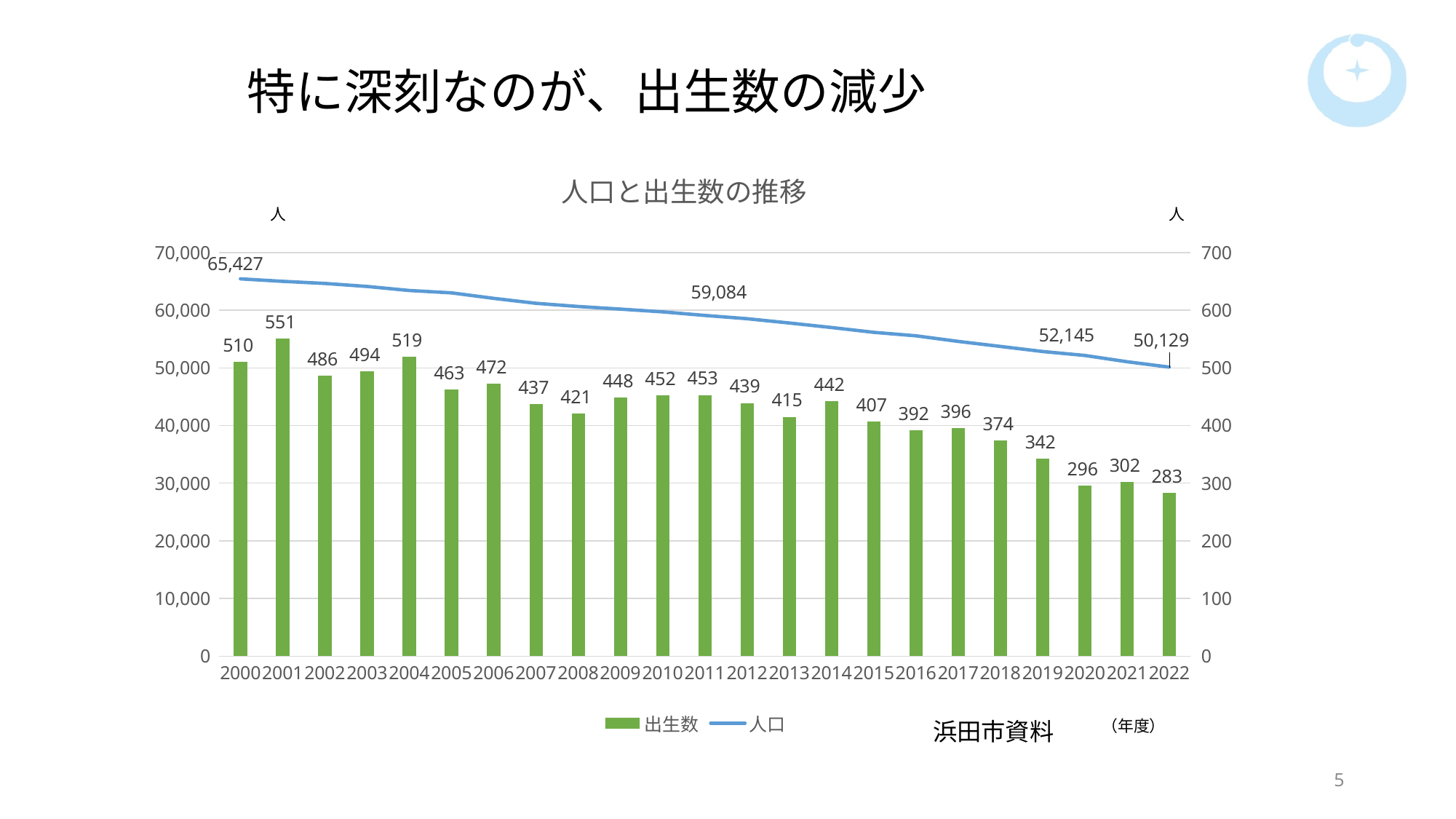
What is the population (人口) value labelled for 2000? 65,427 What is the population (人口) value labelled for 2022? 50,129 What is the number of births (出生数) shown for 2022? 283 How many years are shown on the x axis of the chart? 23 Which year had more births (出生数), 2020 or 2021? 2021 Which year has the lowest number of births (出生数)? 2022 Is the population (人口) value for 2015 greater or less than 60,000? less How many series does the legend list? 2 Which year has the highest number of births (出生数)? 2001 By how much did the number of births (出生数) fall from 2000 to 2022? 227 By how much did the population (人口) fall from 2000 to 2022? 15,298 What is the number of births (出生数) shown for 2001? 551